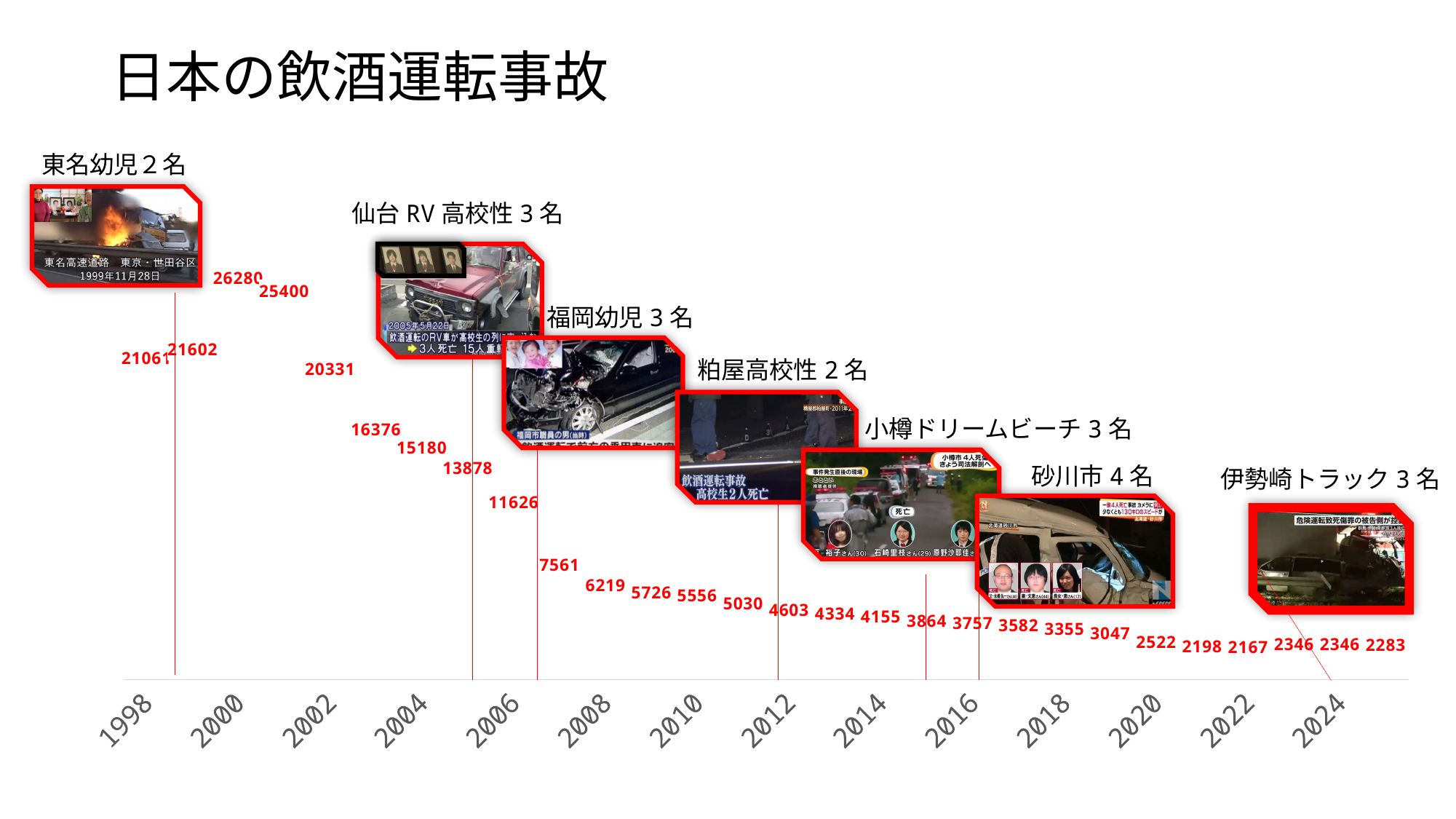
What is the difference between the values labelled at 2000 and 2002? 5949 What is the value labelled at the year 2006? 11626 Do the values generally rise or fall from 2000 to 2022 along the x axis? fall Which year has the larger labelled value, 2004 or 2008? 2004 What is the highest value labelled on the chart? 26280 Is the value labelled at 2000 greater or less than 25000? greater What is the value labelled at the year 2002? 20331 What is the value labelled at the year 2000? 26280 How many accident photos with captions are placed along the chart? 7 What is the title of the slide containing the chart? 日本の飲酒運転事故 What is the lowest value labelled on the chart? 2167 What is the value labelled at the year 2010? 5556